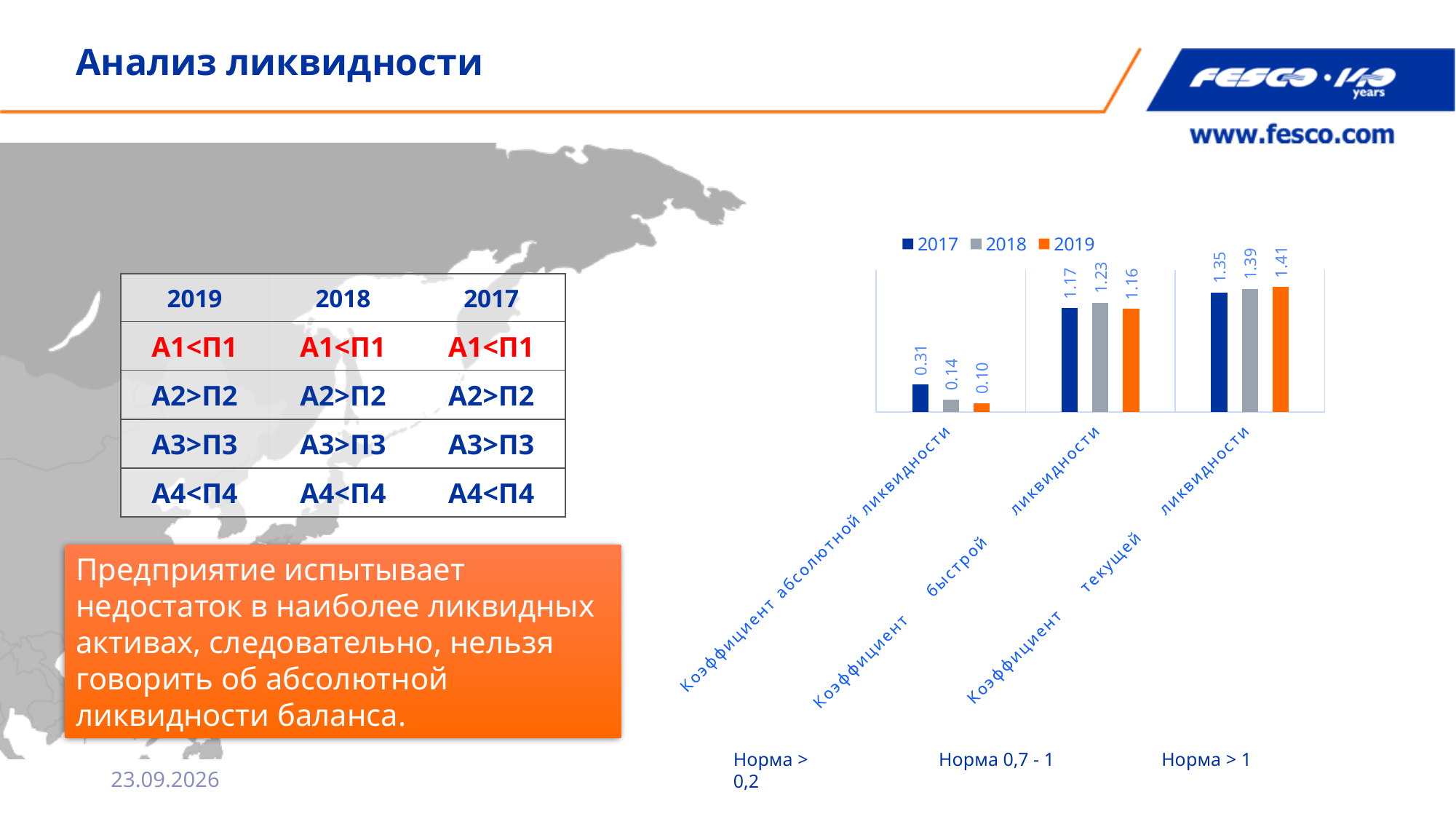
How many categories (coefficients) are shown on the chart's x axis? 3 Which colour represents the 2019 series in the chart? orange What is the value of Коэффициент абсолютной ликвидности for 2017? 0.31 Which year has the lowest value for Коэффициент текущей ликвидности? 2017 Do the values of Коэффициент текущей ликвидности rise or fall from 2017 to 2019? rise How many series does the chart legend list? 3 What is the value of Коэффициент быстрой ликвидности for 2018? 1.23 What is the value of Коэффициент текущей ликвидности for 2019? 1.41 Which year has the highest value for Коэффициент абсолютной ликвидности? 2017 What is the difference between the 2017 and 2019 values of Коэффициент абсолютной ликвидности? 0.21 What kind of chart is shown on the slide? bar chart Which is larger: the 2018 value of Коэффициент быстрой ликвидности or the 2019 value of Коэффициент быстрой ликвидности? 2018